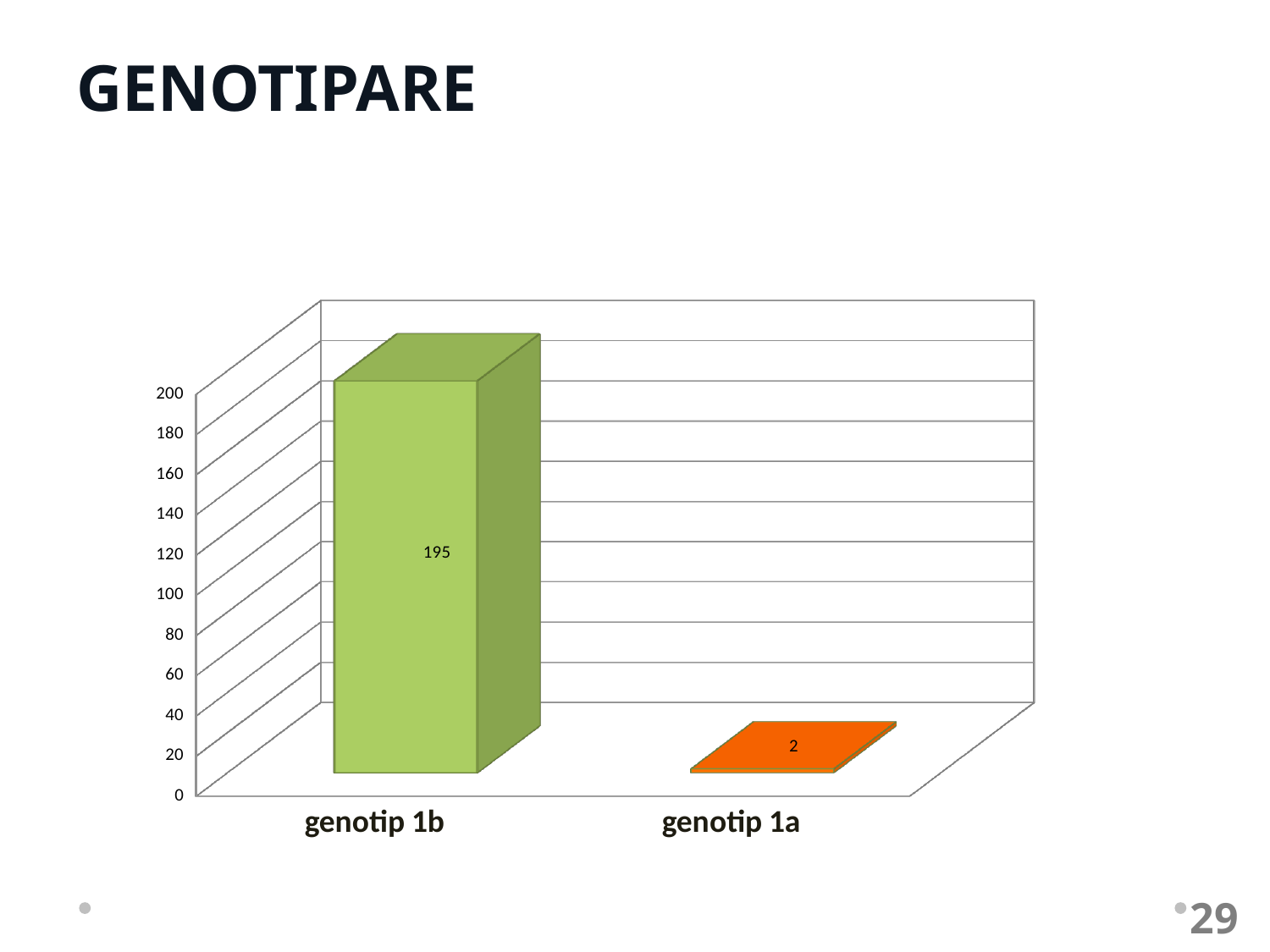
What kind of chart is shown on the slide? bar chart Is the value for genotip 1b greater or less than 100? greater What is the value for genotip 1a? 2 Which is larger, the value for genotip 1b or genotip 1a? genotip 1b How many categories are shown on the chart? 2 Is the value for genotip 1a greater or less than 20? less What colour is the bar for genotip 1a? orange What is the value for genotip 1b? 195 Which category has the lowest value? genotip 1a What is the difference between the values for genotip 1b and genotip 1a? 193 Which category has the highest value? genotip 1b What is the title of the slide? GENOTIPARE